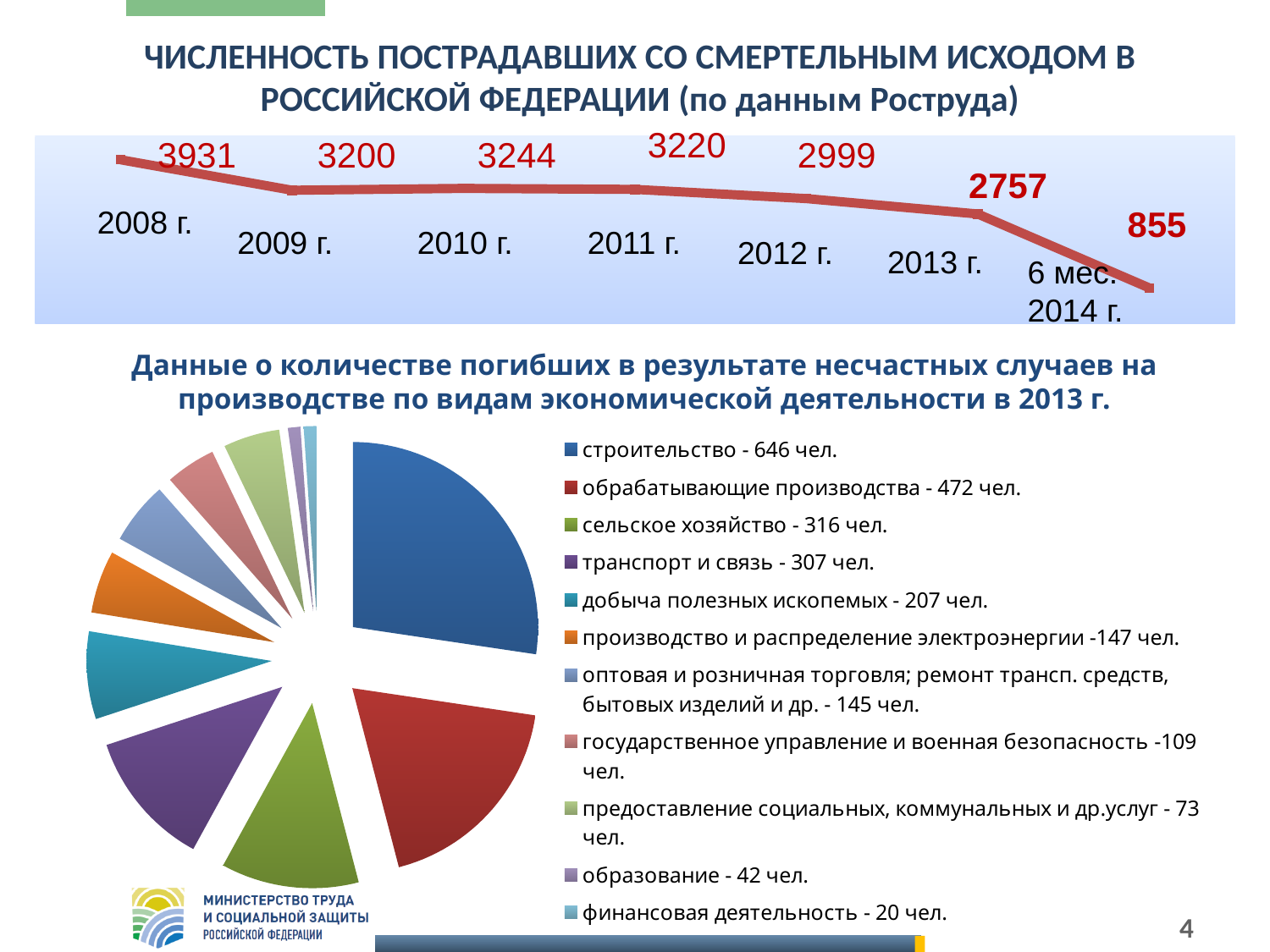
What kind of chart is the top chart on the slide? line chart On the bottom pie chart, how many people died in строительство according to the legend? 646 чел. How many data points are plotted on the top line chart? 7 On the top line chart, what is the value for 2013 г.? 2757 How many categories does the legend of the bottom pie chart list? 11 On the bottom pie chart, what is the difference between строительство and обрабатывающие производства? 174 чел. On the top line chart, what is the number of fatalities for 2008 г.? 3931 On the top line chart, which is larger, the value for 2009 г. or for 2010 г.? 2010 г. On the top line chart, which year has the highest value? 2008 г. On the top line chart, which period has the lowest value? 6 мес. 2014 г. On the top line chart, what is the difference between the values for 2012 г. and 2013 г.? 242 On the top line chart, do the values generally rise or fall from 2008 г. to 6 мес. 2014 г.? fall